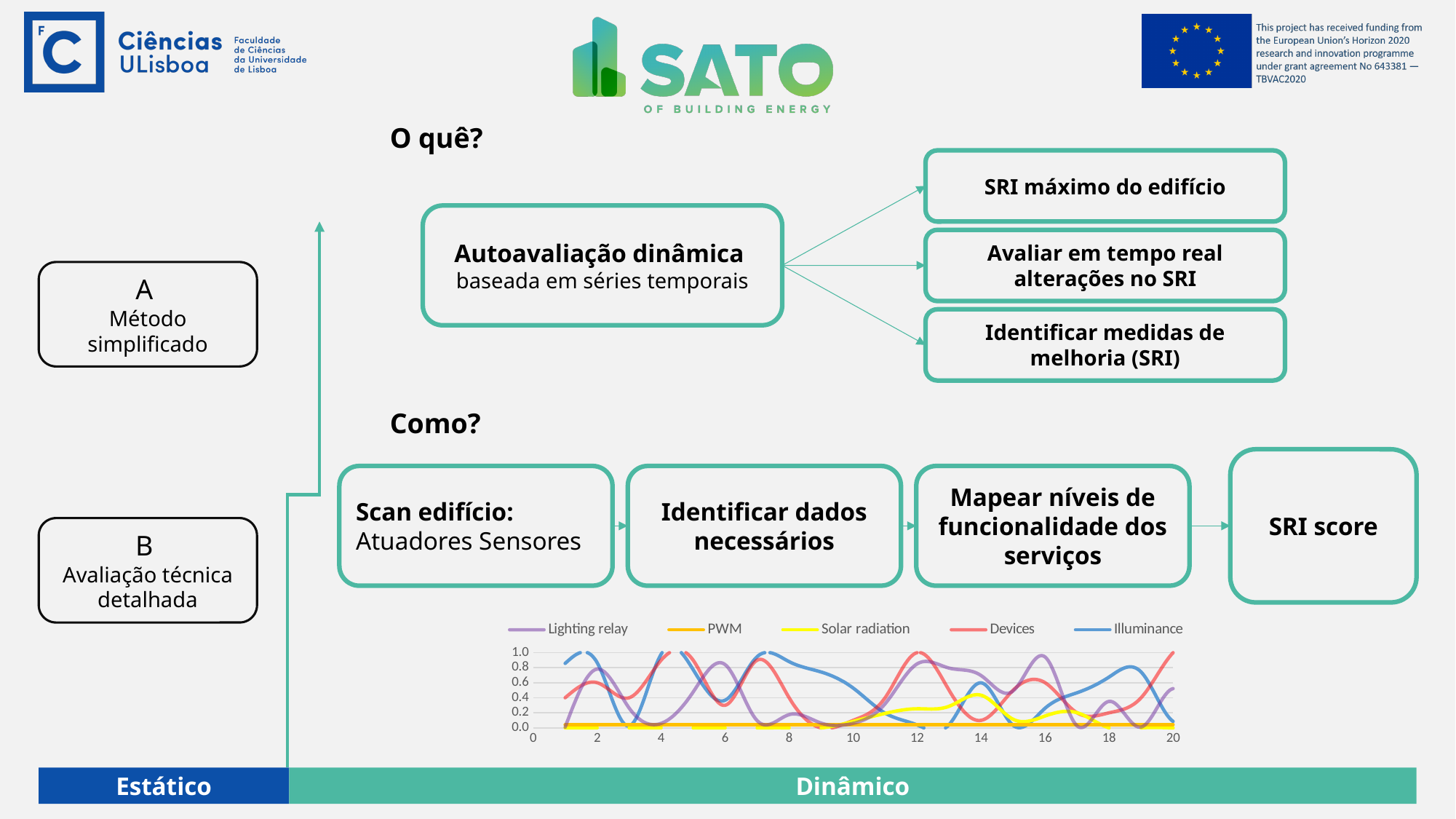
Which series in the chart legend is drawn in purple? Lighting relay Is the value for Solar radiation at x = 14 greater or less than 0.8? less Is the value for Devices at x = 20 greater or less than 0.6? greater What is the highest value shown on the y axis of the chart? 1.0 How many series does the legend of the chart list? 5 Is the value for Illuminance at x = 7 greater or less than 0.6? greater What kind of chart is shown at the bottom of the slide? line chart Which series in the chart legend is drawn in yellow? Solar radiation